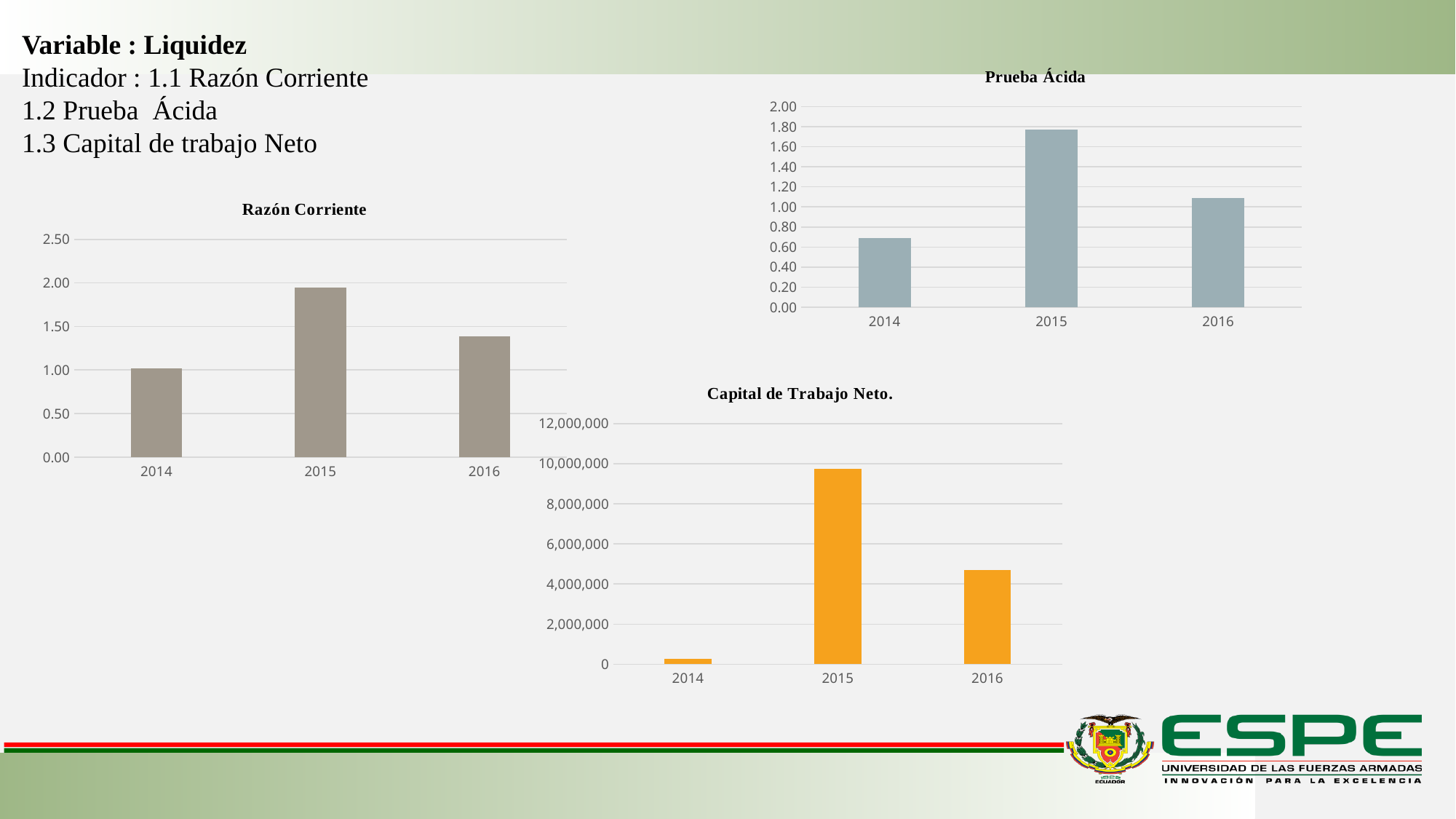
In the Capital de Trabajo Neto chart, is the value for 2015 greater or less than 8,000,000? greater In the Capital de Trabajo Neto chart, is the value for 2016 larger than the value for 2014? yes In the Razón Corriente chart, is the value for 2016 greater or less than 1.50? less How many years are shown on the x axis of the Prueba Ácida chart? 3 In the Capital de Trabajo Neto chart, which year has the lowest value? 2014 In the Razón Corriente chart, which year has the lowest value? 2014 In the Razón Corriente chart, which year has the highest value? 2015 What kind of chart is the Capital de Trabajo Neto chart? bar chart In the Prueba Ácida chart, is the value for 2014 greater or less than 1.00? less In the Prueba Ácida chart, which year has the highest value? 2015